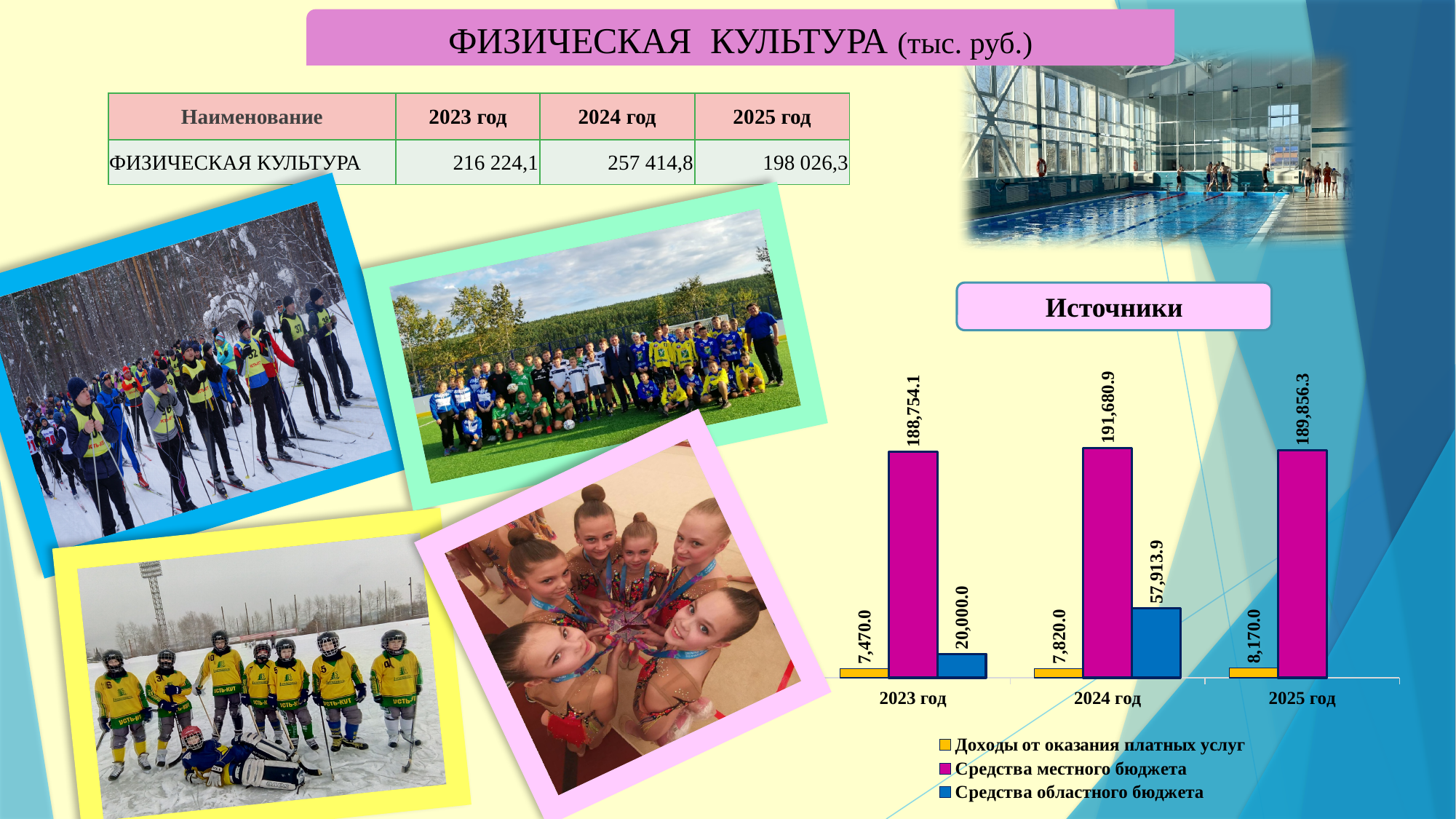
In the "Источники" chart, what is the difference between "Средства областного бюджета" in 2024 год and in 2023 год? 37,913.9 How many series does the legend of the "Источники" chart list? 3 How many year categories are shown on the x axis of the "Источники" chart? 3 In the "Источники" chart, what is the value of "Средства местного бюджета" for 2024 год? 191,680.9 In the "Источники" chart, which year has the lowest value for "Доходы от оказания платных услуг"? 2023 год In the "Источники" chart, do the values of "Доходы от оказания платных услуг" rise or fall from 2023 год to 2025 год? rise In the "Источники" chart, what is the value of "Средства областного бюджета" for 2023 год? 20,000.0 In the "Источники" chart, what is the value of "Доходы от оказания платных услуг" for 2025 год? 8,170.0 What kind of chart is shown under the heading "Источники"? bar chart In the "Источники" chart, which is larger: "Средства местного бюджета" in 2023 год or in 2025 год? 2025 год In the "Источники" chart, what colour are the bars for "Средства местного бюджета"? magenta In the "Источники" chart, which year has the highest value for "Средства областного бюджета"? 2024 год